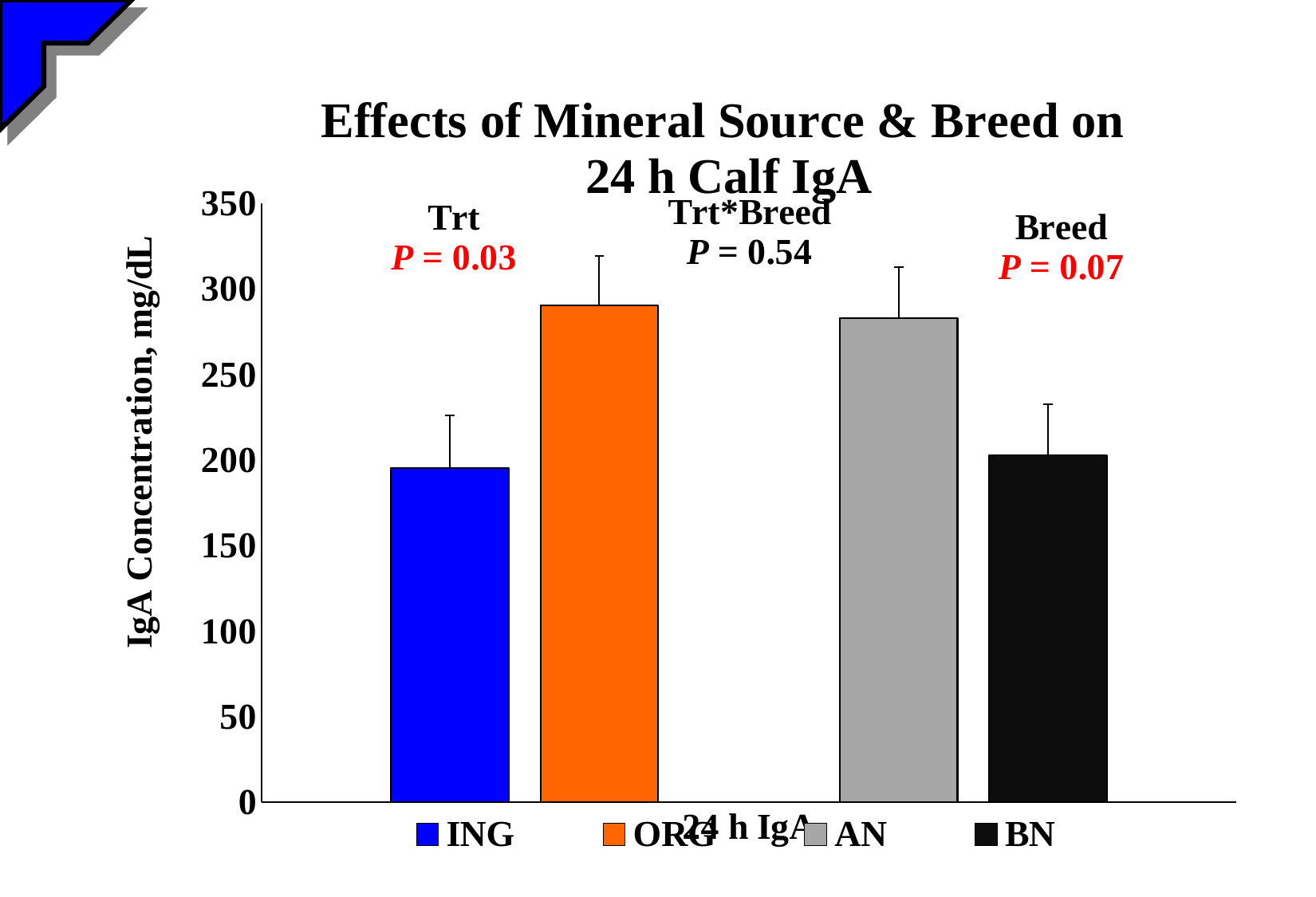
Which is larger, the value for AN or the value for BN? AN What kind of chart is shown on the slide? bar chart How many bars are plotted in the chart? 4 Is the value for BN greater or less than 150? greater How many series does the legend list? 4 Is the value for ORG greater or less than 250? greater Is the value for AN greater or less than 250? greater Which is larger, the value for ING or the value for ORG? ORG Which is larger, the value for ORG or the value for BN? ORG What is the label on the vertical axis? IgA Concentration, mg/dL What is the title of the chart? Effects of Mineral Source & Breed on 24 h Calf IgA